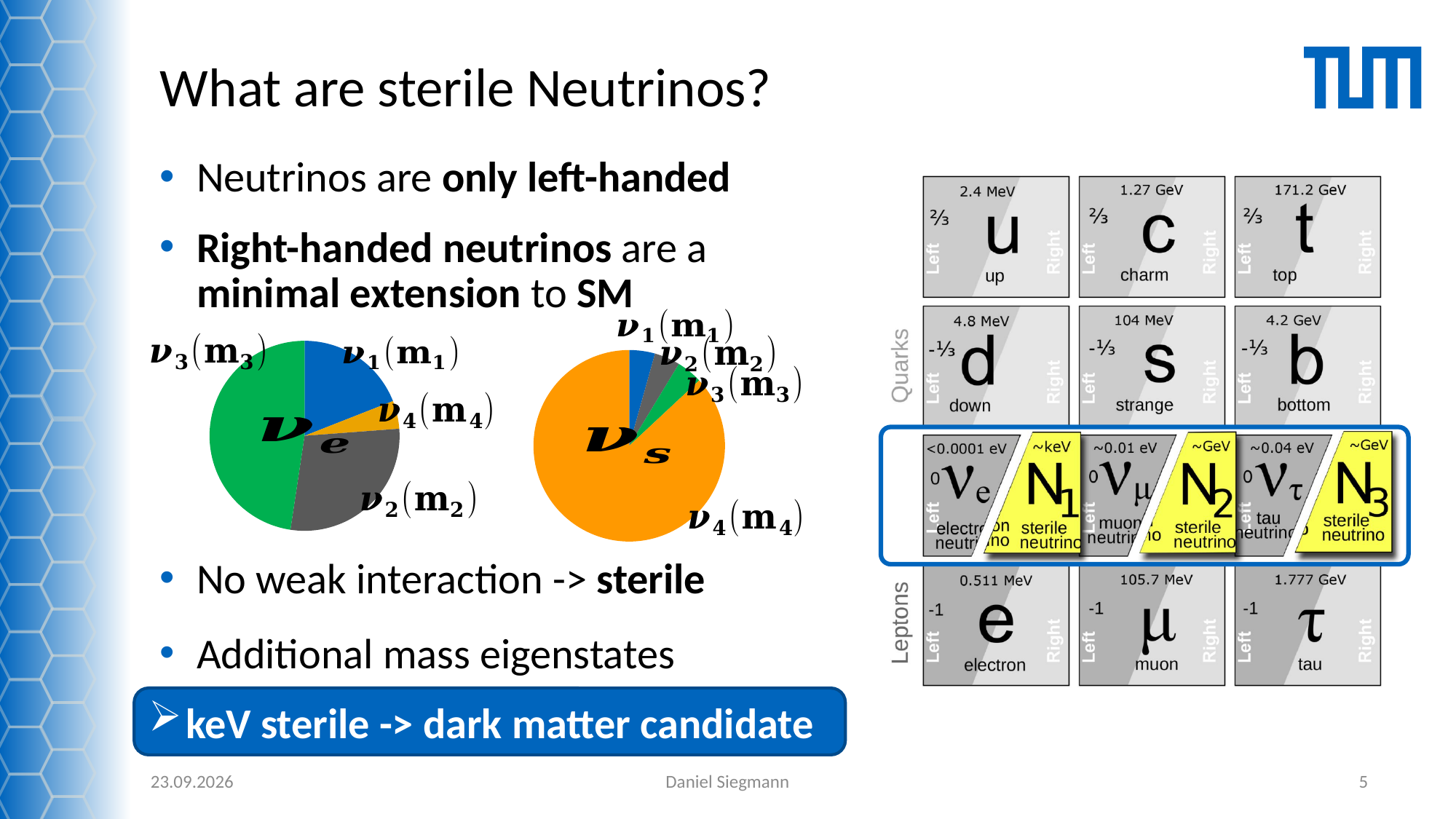
In the left pie chart (ν_e), which slice is the largest? ν3(m3) In the right pie chart (ν_s), which slice is larger, ν4(m4) or ν1(m1)? ν4(m4) In the left pie chart (ν_e), which slice is larger, ν3(m3) or ν1(m1)? ν3(m3) In the left pie chart (ν_e), which slice is the smallest? ν4(m4) In the right pie chart (ν_s), which slice is the largest? ν4(m4) In the left pie chart (ν_e), which slice is larger, ν2(m2) or ν4(m4)? ν2(m2) What kind of chart is the left chart labelled ν_e? pie chart In the left pie chart (ν_e), what colour is the ν3(m3) slice? green In the right pie chart (ν_s), what colour is the ν4(m4) slice? orange In the right pie chart (ν_s), how many slices are there? 4 In the left pie chart (ν_e), how many slices are there? 4 What kind of chart is the right chart labelled ν_s? pie chart